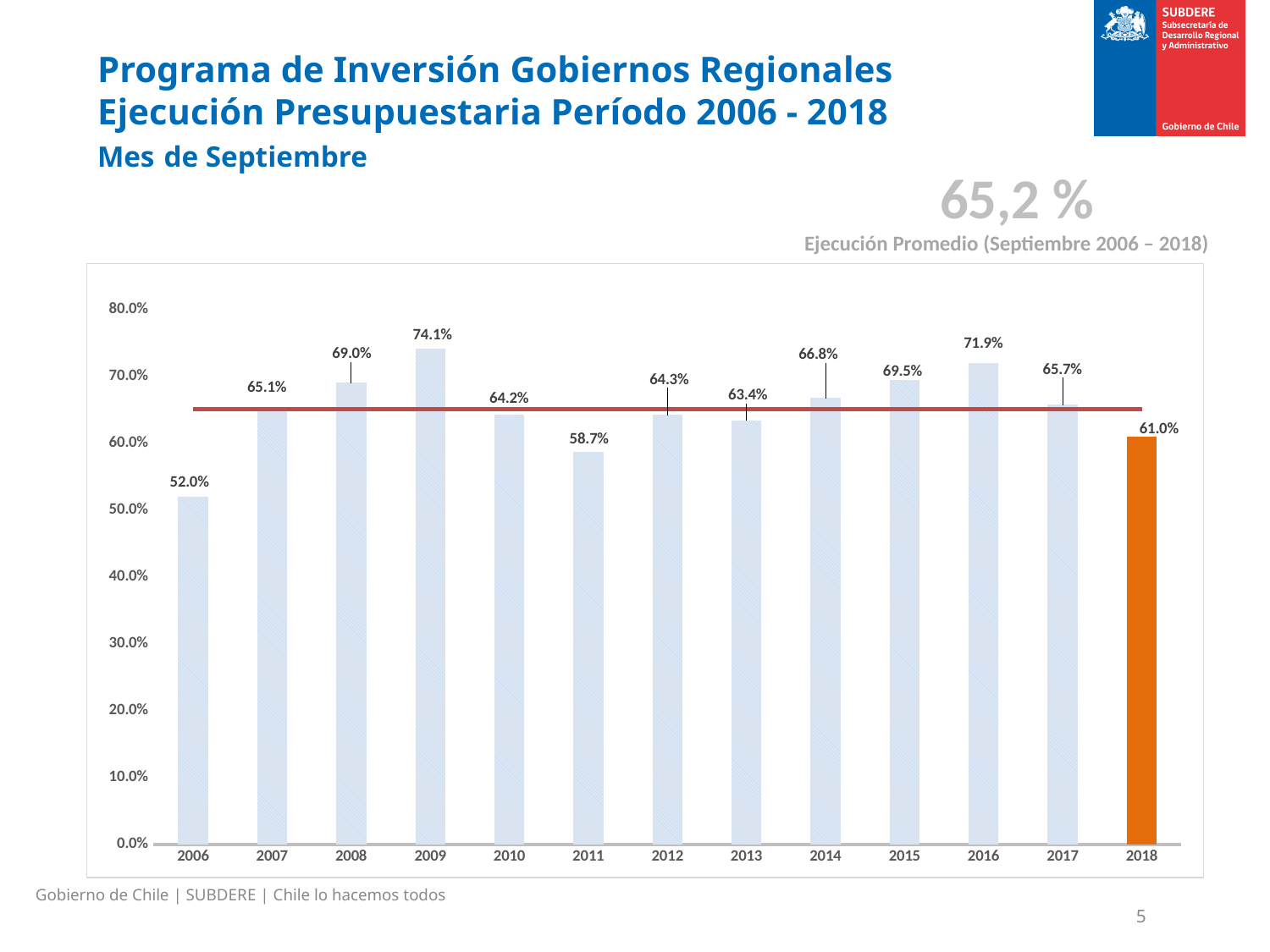
Is the value for 2014 greater or less than 60.0%? greater What is the difference between the values for 2016 and 2018? 10.9% Which year has the highest value? 2009 What kind of chart is this? bar chart Which is larger, the value for 2008 or the value for 2015? 2015 What is the value for 2009? 74.1% Which bar is coloured orange? 2018 What is the value for 2011? 58.7% What is the difference between the values for 2009 and 2006? 22.1% How many years are shown on the x axis? 13 What is the value for 2018? 61.0% Which year has the lowest value? 2006